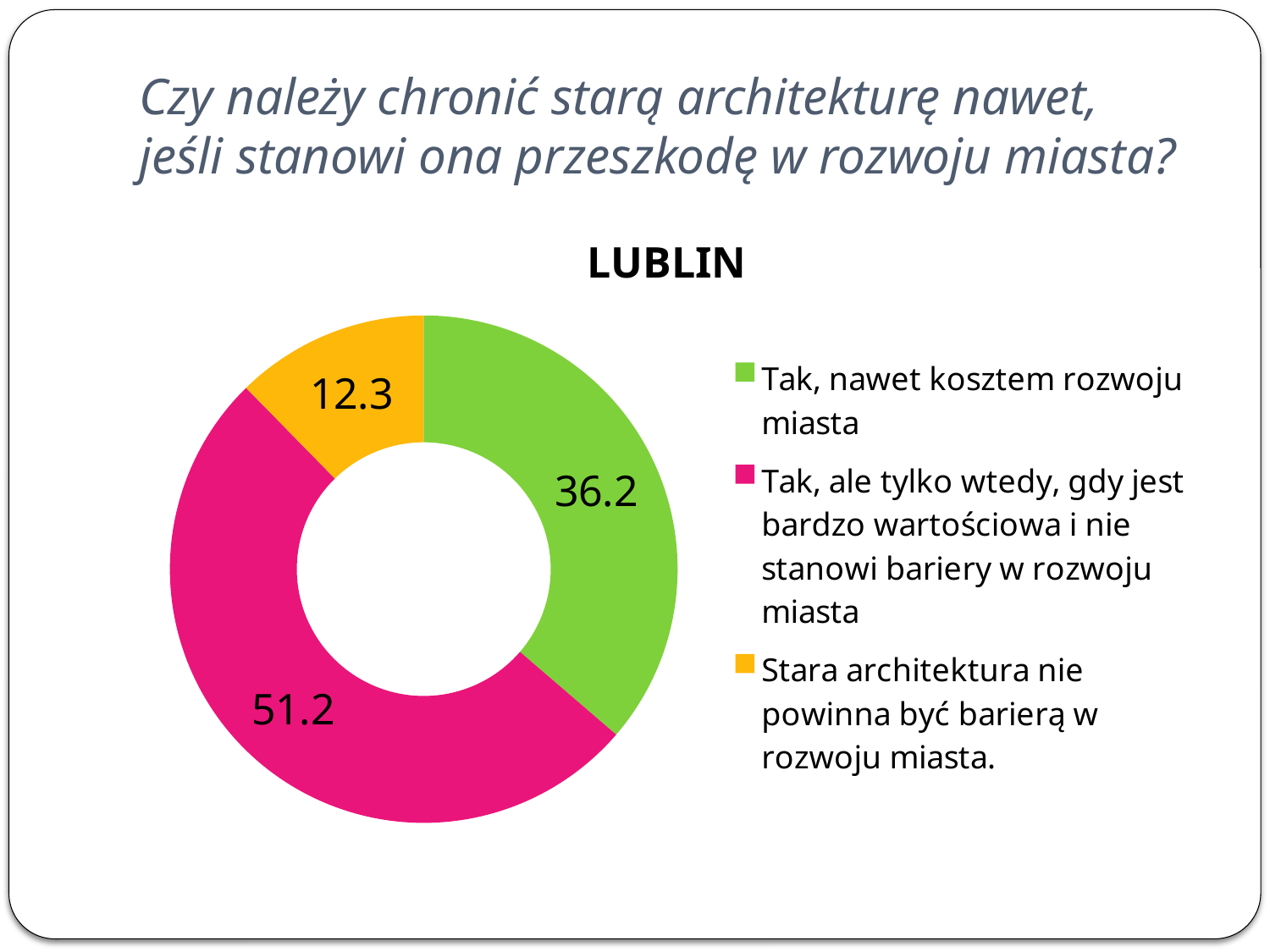
Which colour represents "Stara architektura nie powinna być barierą w rozwoju miasta." in the chart? Orange What is the difference between the values for "Tak, ale tylko wtedy..." (51.2) and "Tak, nawet kosztem rozwoju miasta" (36.2)? 15.0 How many slices does the chart have? 3 Which is larger: the slice for "Tak, nawet kosztem rozwoju miasta" or the slice for "Stara architektura nie powinna być barierą w rozwoju miasta."? Tak, nawet kosztem rozwoju miasta What value is shown for the slice "Tak, ale tylko wtedy, gdy jest bardzo wartościowa i nie stanowi bariery w rozwoju miasta"? 51.2 Which category has the smallest slice in the chart? Stara architektura nie powinna być barierą w rozwoju miasta. What value is shown for the slice "Stara architektura nie powinna być barierą w rozwoju miasta."? 12.3 What is the title of the chart? LUBLIN What value is shown for the slice "Tak, nawet kosztem rozwoju miasta"? 36.2 What is the difference between the values for "Tak, nawet kosztem rozwoju miasta" and "Stara architektura nie powinna być barierą w rozwoju miasta."? 23.9 What kind of chart is shown on the slide? Doughnut (pie) chart Which category has the largest slice in the chart? Tak, ale tylko wtedy, gdy jest bardzo wartościowa i nie stanowi bariery w rozwoju miasta